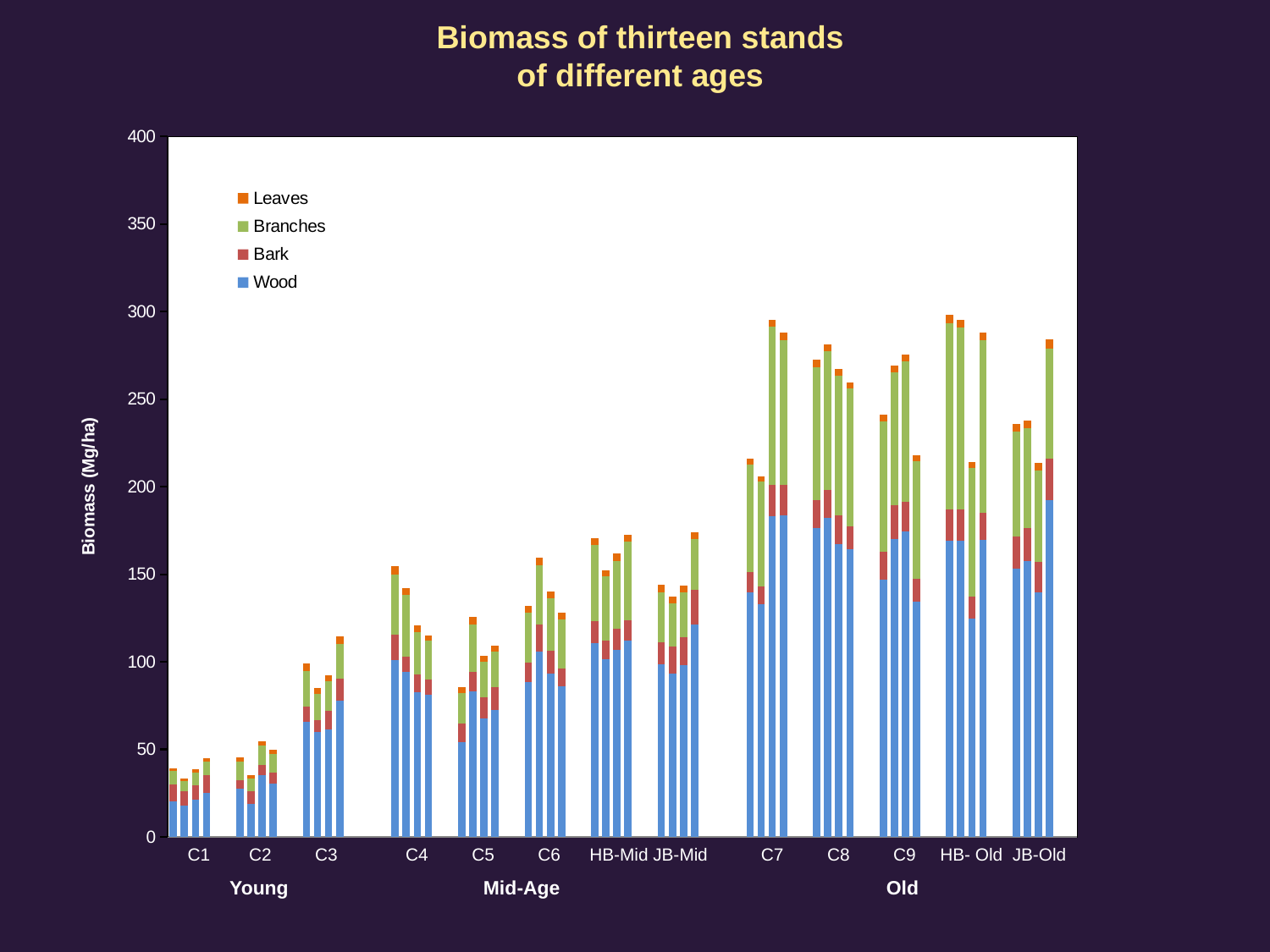
Are the biomass values for the C1 bars greater or less than 50 Mg/ha? less How many series does the legend list? 4 Are the bars for C3 greater or less than 150 Mg/ha? less Which stand has higher biomass bars, C4 or C2? C4 What is the label of the y axis? Biomass (Mg/ha) What is the title of the chart? Biomass of thirteen stands of different ages Which stand has higher biomass bars, C7 or C1? C7 Is the tallest bar for C7 greater or less than 250 Mg/ha? greater How many stands are labelled along the x axis? 13 Which stand has the lowest biomass bars? C1 Do the biomass values generally rise or fall moving from the Young stands to the Old stands along the x axis? rise What kind of chart is shown on the slide? Stacked bar chart